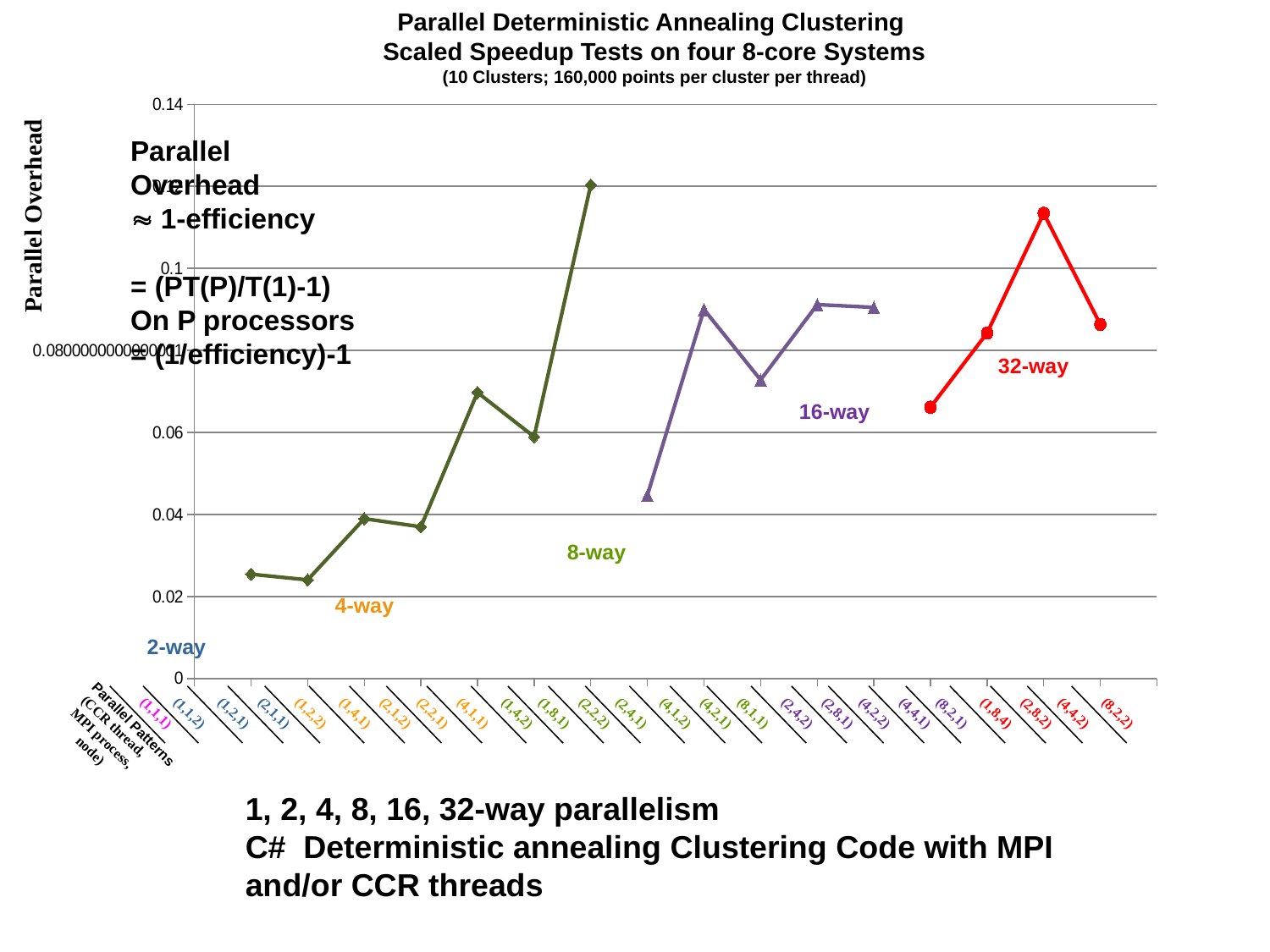
What is the title of the y axis? Parallel Overhead What is the highest tick value shown on the y axis? 0.14 Is the lowest point of the purple 16-way line greater or less than 0.06? less Is the first point of the red 32-way line greater or less than 0.08? less What kind of chart is shown on the slide? line chart Is the peak of the red 32-way line greater or less than 0.1? greater Which line contains the lowest plotted parallel overhead value: the green line or the purple 16-way line? green line How many data points are plotted on the green line? 7 Does the red 32-way line rise steadily, fall steadily, or rise and then fall from left to right? rise and then fall How many data points are plotted on the purple 16-way line? 5 How many data points are plotted on the red 32-way line? 4